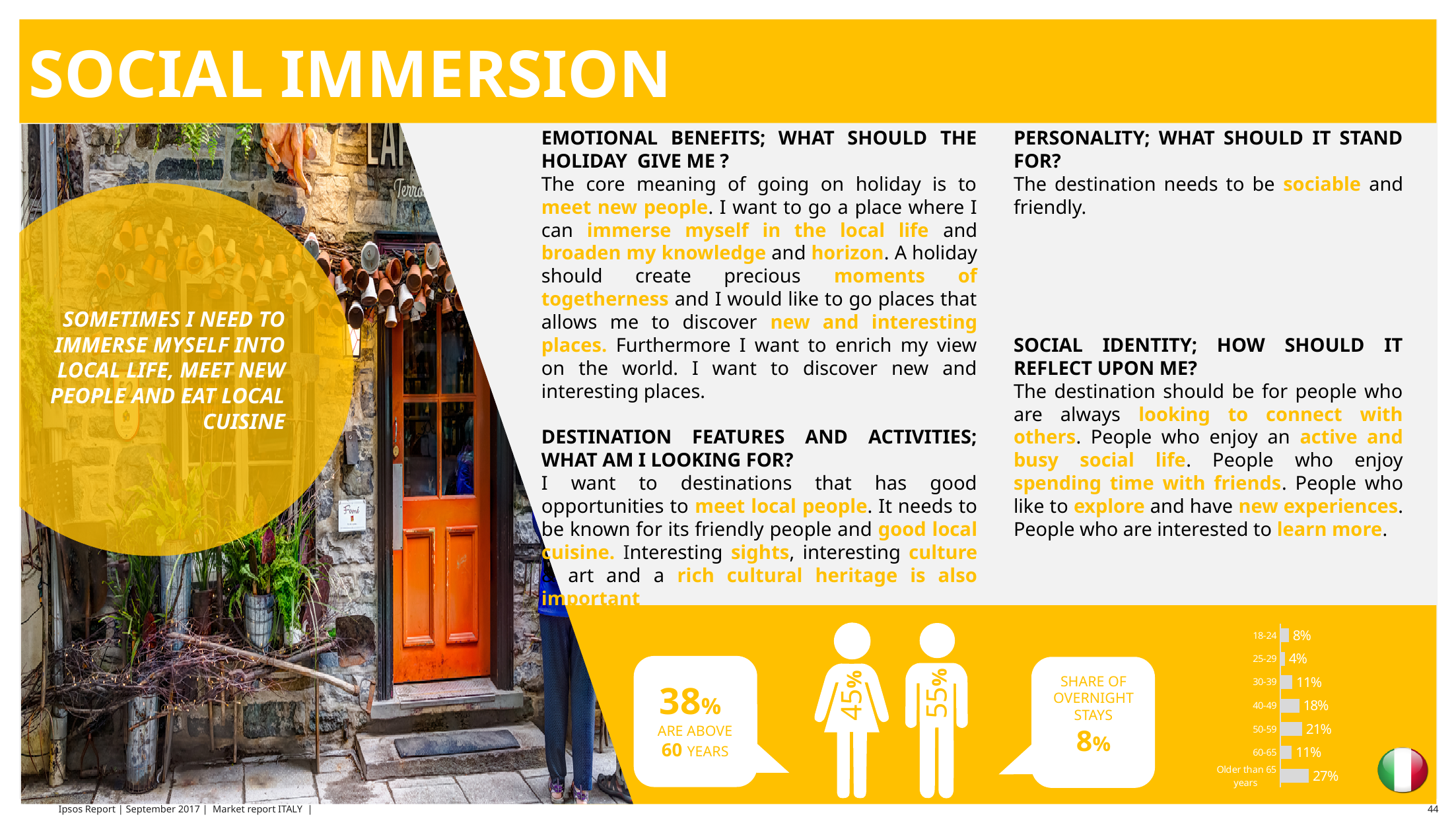
What kind of chart is shown at the bottom right of the slide? Bar chart In the age-group bar chart at the bottom right, what is the value for Older than 65 years? 27% In the age-group bar chart at the bottom right, which age group has the lowest value? 25-29 In the age-group bar chart at the bottom right, what is the value for 18-24? 8% In the age-group bar chart at the bottom right, what is the difference between the values for Older than 65 years and 18-24? 19% In the age-group bar chart at the bottom right, which is larger, the value for 30-39 or the value for 40-49? 40-49 In the age-group bar chart at the bottom right, do the values for 30-39 and 60-65 match? Yes, both are 11% In the age-group bar chart at the bottom right, which age group has the highest value? Older than 65 years In the age-group bar chart at the bottom right, what is the value for 50-59? 21% In the age-group bar chart at the bottom right, what is the value for 40-49? 18% How many age groups are shown in the bar chart at the bottom right? 7 In the age-group bar chart at the bottom right, what is the difference between the values for 50-59 and 40-49? 3%